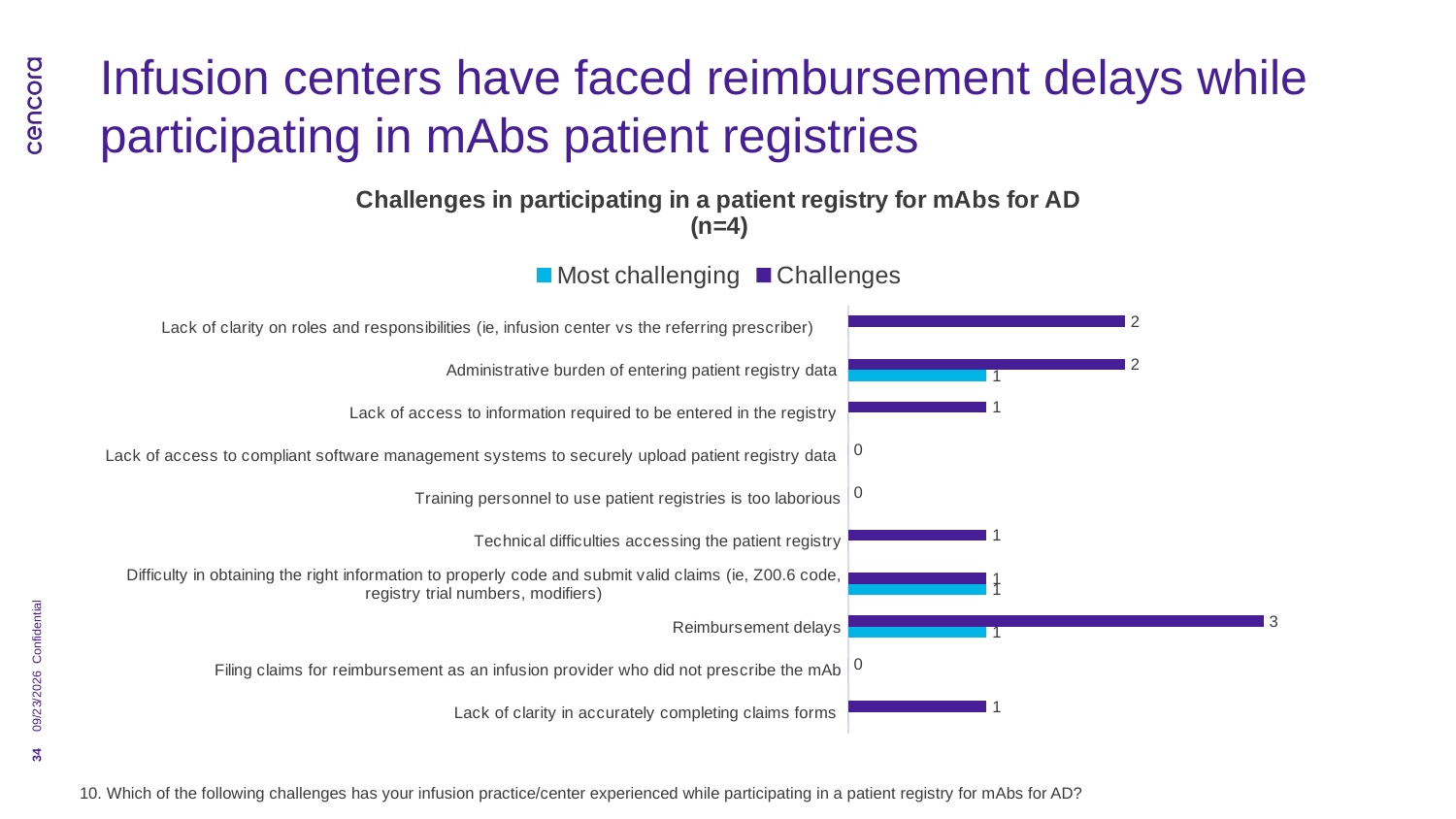
What kind of chart is shown on the slide? Bar chart What are the two legend entries on the chart? Most challenging and Challenges Which has a larger Challenges value: Lack of clarity on roles and responsibilities or Technical difficulties accessing the patient registry? Lack of clarity on roles and responsibilities What is the value shown for Training personnel to use patient registries is too laborious? 0 How many challenge categories are listed on the chart? 10 How many series does the legend list? 2 What is the Challenges value for Reimbursement delays? 3 What is the difference between the Challenges value for Reimbursement delays and the Challenges value for Administrative burden of entering patient registry data? 1 Which category has the highest value for the Challenges series? Reimbursement delays What is the Challenges value for Administrative burden of entering patient registry data? 2 What is the Most challenging value for Reimbursement delays? 1 How many categories show a value of 0? 3